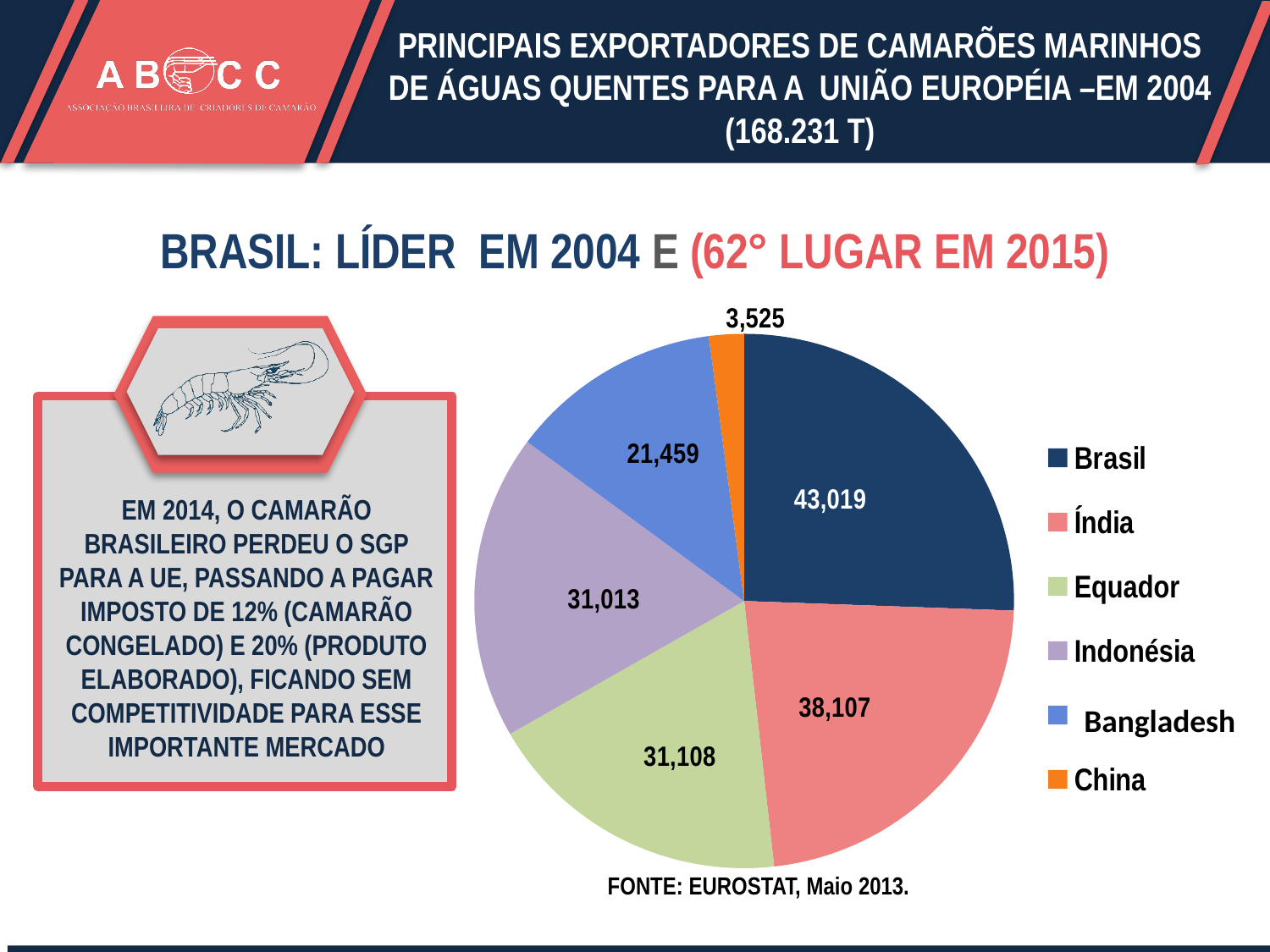
Which country has the smallest slice of the pie chart? China Which country has the largest slice of the pie chart? Brasil Which has a larger value, Índia or Equador? Índia What is the value shown for Bangladesh in the pie chart? 21,459 What is the value shown for Brasil in the pie chart? 43,019 What is the value shown for Índia in the pie chart? 38,107 What is the value shown for China in the pie chart? 3,525 What kind of chart is shown on the slide? Pie chart How many countries are shown in the pie chart? 6 What is the total of all the values shown in the pie chart? 168,231 What colour is the slice for Brasil in the pie chart? Dark blue What is the difference between the values for Brasil and Índia? 4,912